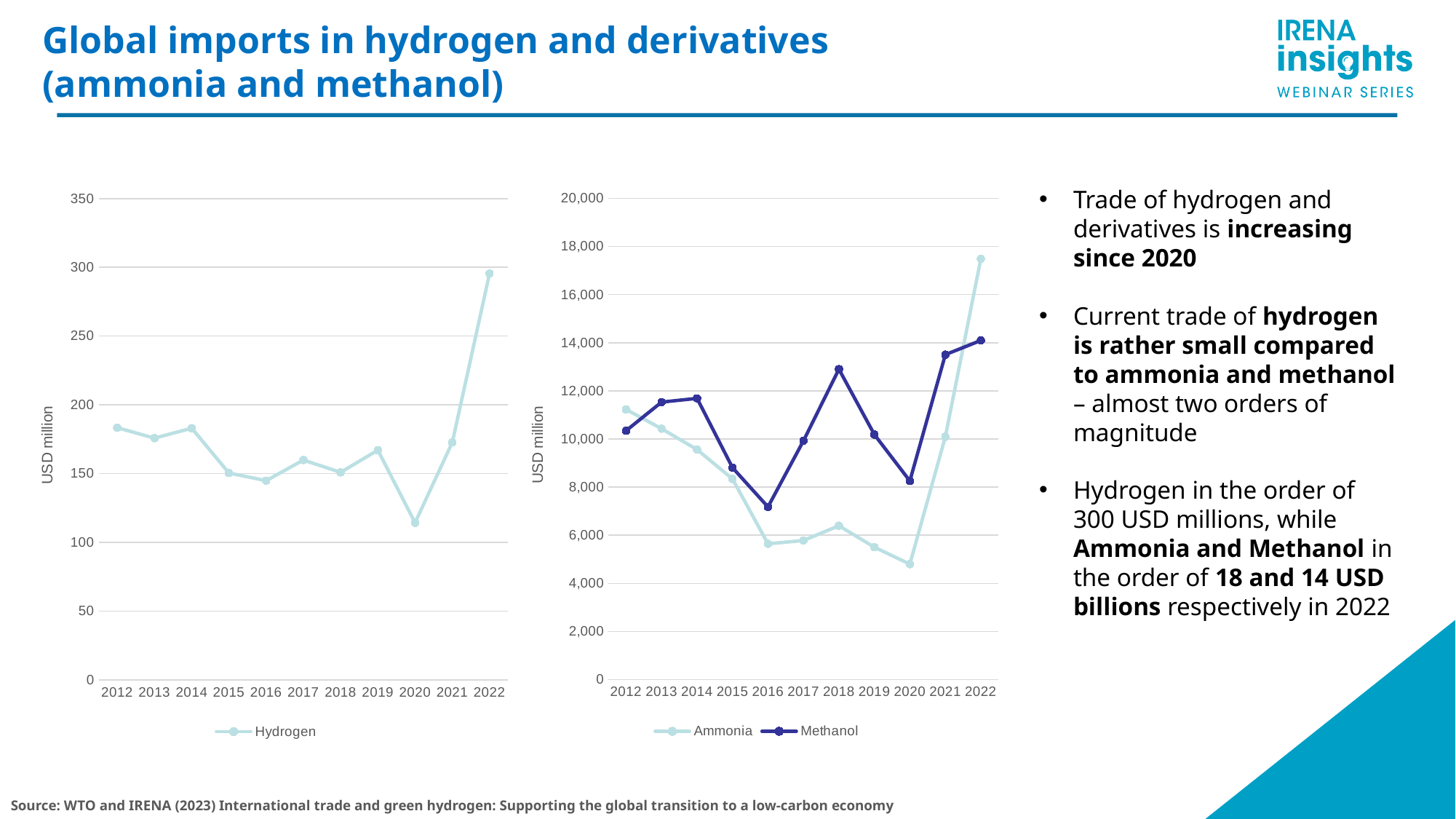
In the right chart, which year has the lowest Methanol value? 2016 How many series does the legend of the right chart list? 2 What is the y-axis label of the right chart? USD million In the left Hydrogen chart, is the value for 2022 greater or less than 250? greater In the right chart, which year has the highest Ammonia value? 2022 In the right chart, is the Ammonia value for 2022 greater or less than 16,000? greater How many years are plotted on the x axis of the left Hydrogen chart? 11 In the left Hydrogen chart, is the value for 2012 greater or less than 200? less In the left Hydrogen chart, which year has the lowest value? 2020 In the right chart, which series has the larger value in 2018, Ammonia or Methanol? Methanol What kind of chart is the left chart showing Hydrogen? line chart In the left Hydrogen chart, which year has the highest value? 2022